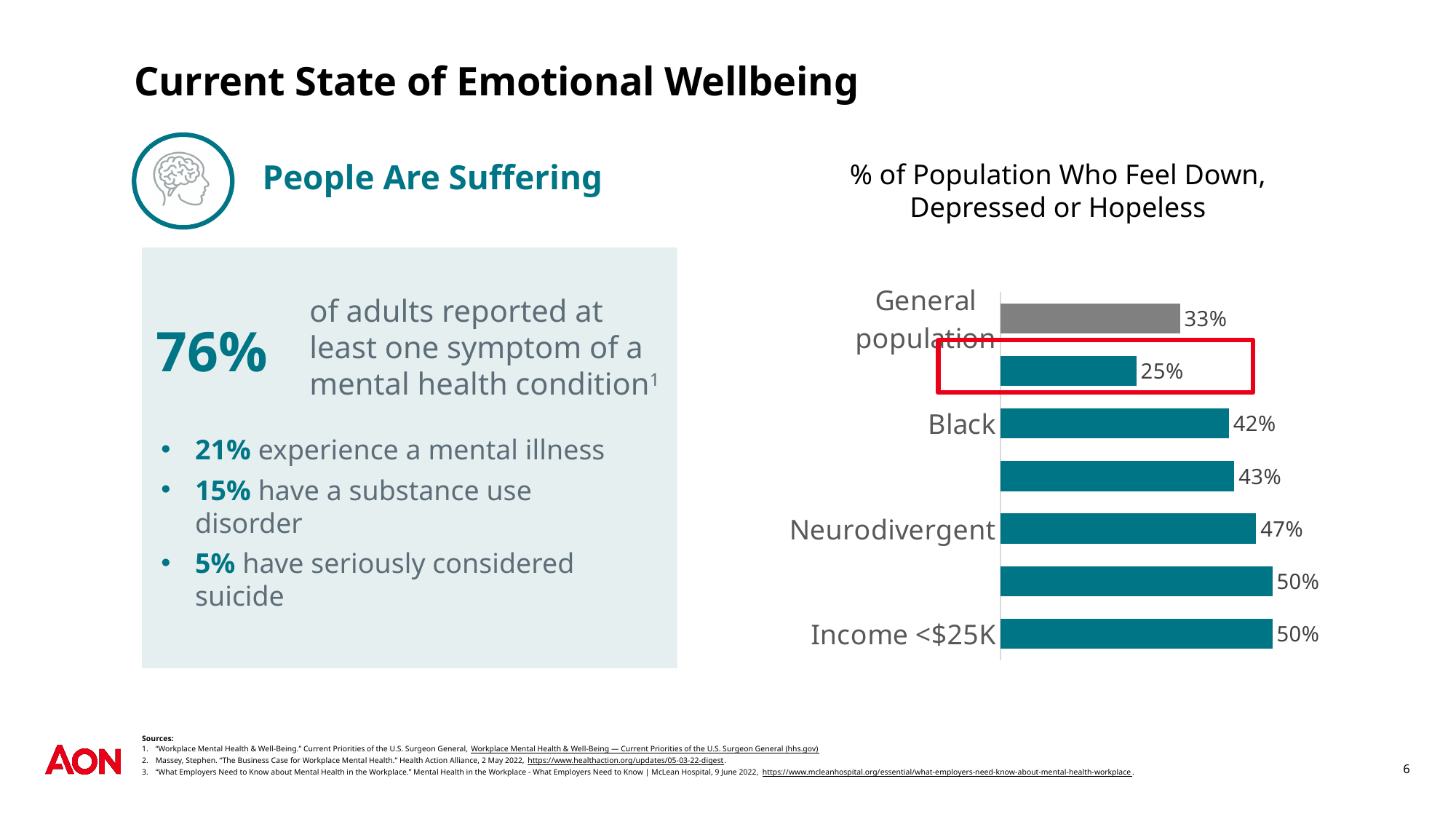
What is the title of the chart? % of Population Who Feel Down, Depressed or Hopeless What is the lowest value shown on any bar in the chart? 25% How many percentage points higher is the Black value than the General population value? 9 percentage points What type of chart is shown on the slide? Bar chart What is the value for General population in the chart? 33% What is the difference between the Income <$25K value and the General population value? 17 percentage points What is the value shown for Income <$25K? 50% What percentage of the Black population feels down, depressed or hopeless according to the chart? 42% How many bars are plotted in the chart? 7 Which is larger, the value for Neurodivergent or the value for Black? Neurodivergent What is the value shown for Neurodivergent? 47% What is the highest value shown on any bar in the chart? 50%